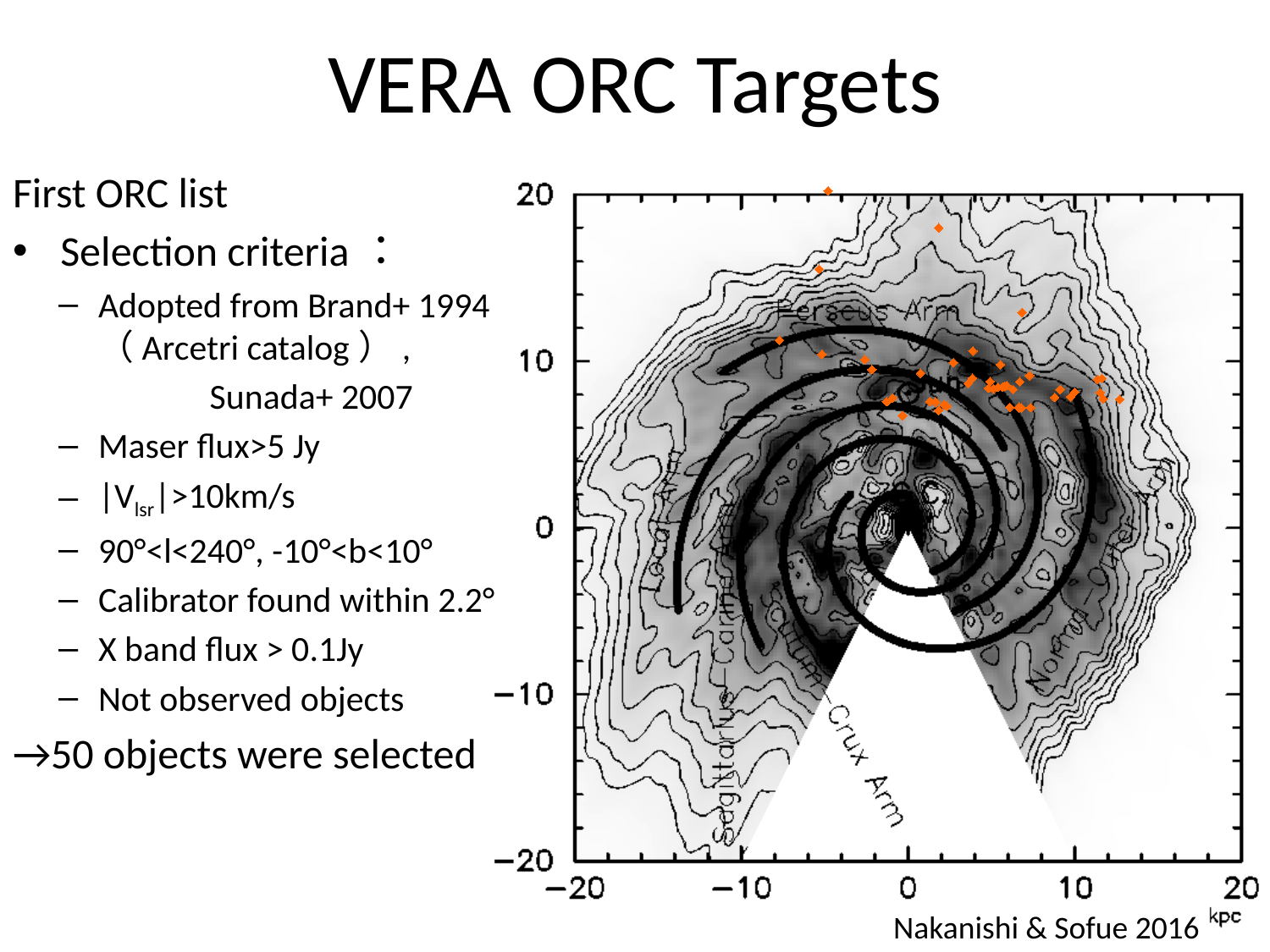
Is the x value of the rightmost orange marker greater or less than 10? greater What unit is indicated for the axes of the map? kpc What kind of plot is shown on the right of the slide? contour map Is the y value of the topmost orange marker greater or less than 10? greater Is the x value of the leftmost orange marker greater or less than 0? less Which reference is the map credited to? Nakanishi & Sofue 2016